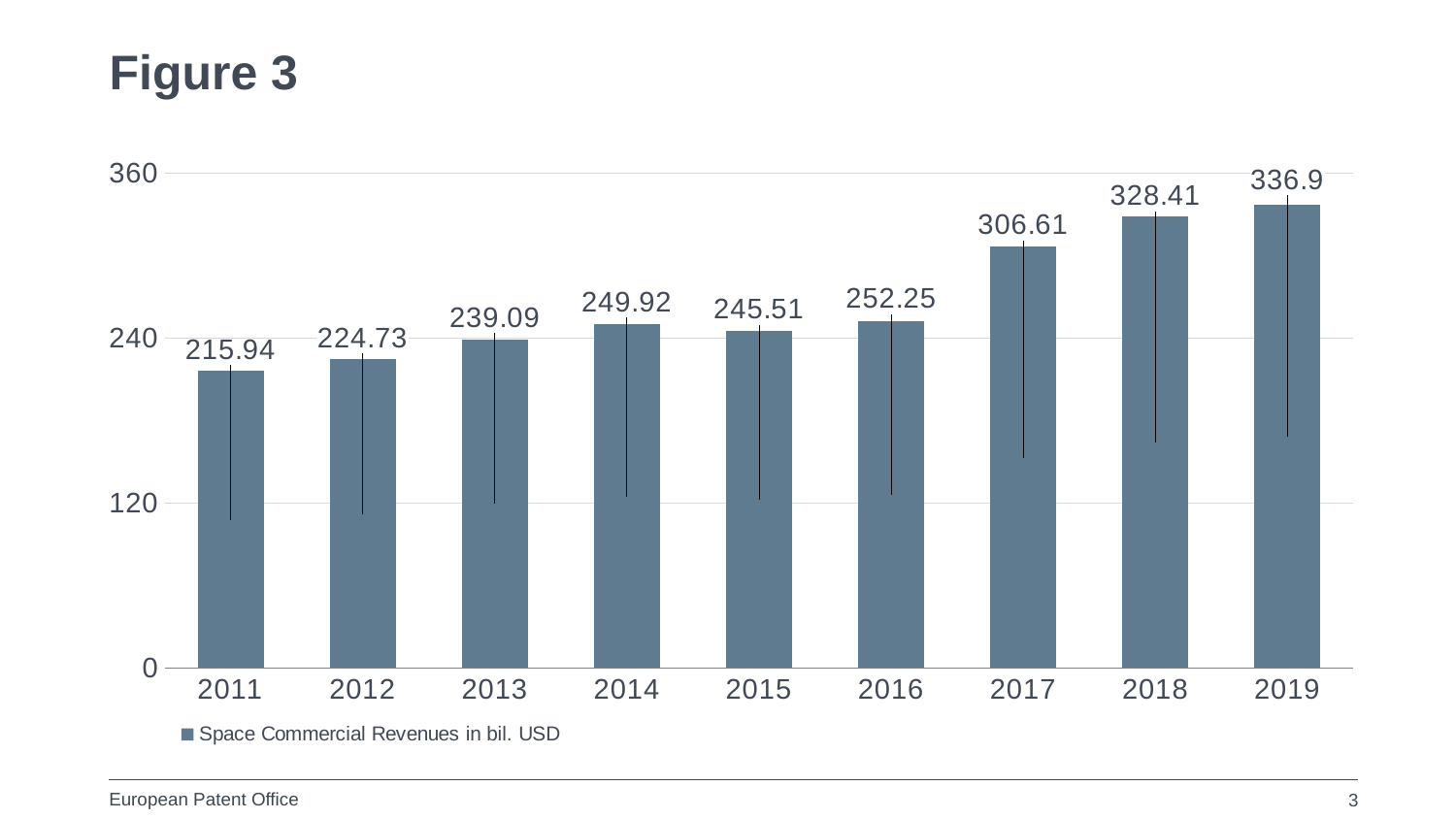
Which is larger, the value for 2014 or the value for 2015? 2014 What is the difference between the values for 2019 and 2018? 8.49 What series name does the legend show? Space Commercial Revenues in bil. USD How many years are shown on the x axis? 9 What is the value for 2015? 245.51 Is the value for 2018 greater or less than 240? greater Which year has the highest value? 2019 What is the value for 2011? 215.94 What kind of chart is shown? bar chart What is the value for 2017? 306.61 Which year has the lowest value? 2011 What is the difference between the values for 2017 and 2016? 54.36